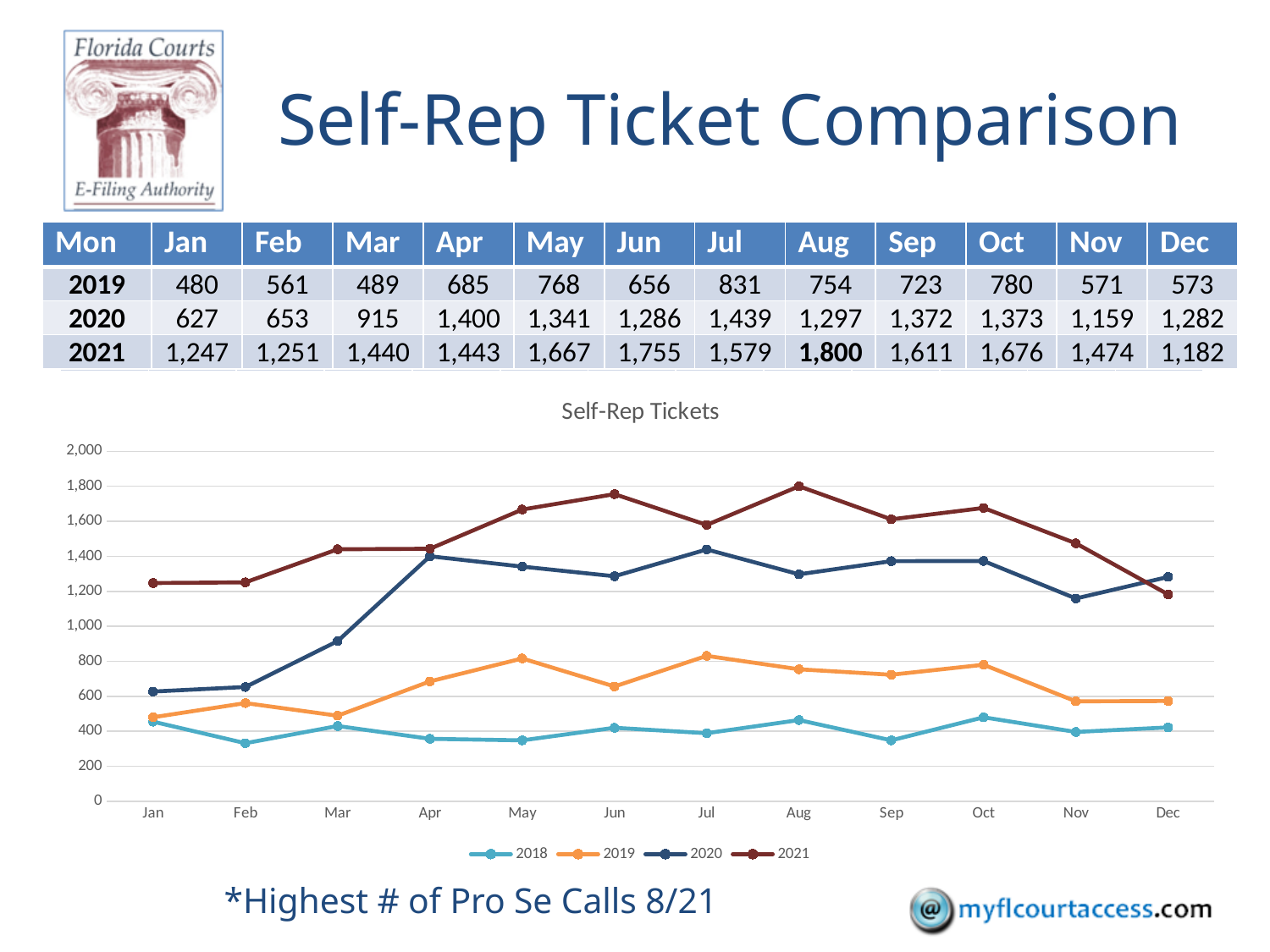
Is the value for 2018 in Feb greater or less than 400 on the "Self-Rep Tickets" chart? less What is the difference between the 2021 and 2020 values in Jan on the "Self-Rep Tickets" chart? 620 In which month is the 2019 series lowest on the "Self-Rep Tickets" chart? Jan What is the title of the line chart on the slide? Self-Rep Tickets How many months are shown on the x axis of the "Self-Rep Tickets" chart? 12 What is the value for 2021 in Aug on the "Self-Rep Tickets" chart? 1,800 What is the value for 2020 in Apr on the "Self-Rep Tickets" chart? 1,400 Which is larger in Dec on the "Self-Rep Tickets" chart, the 2020 value or the 2021 value? 2020 How many series does the legend of the "Self-Rep Tickets" chart list? 4 Does the 2020 series rise or fall from Feb to Apr on the "Self-Rep Tickets" chart? rise What kind of chart is the "Self-Rep Tickets" chart? line chart In which month is the 2021 series highest on the "Self-Rep Tickets" chart? Aug